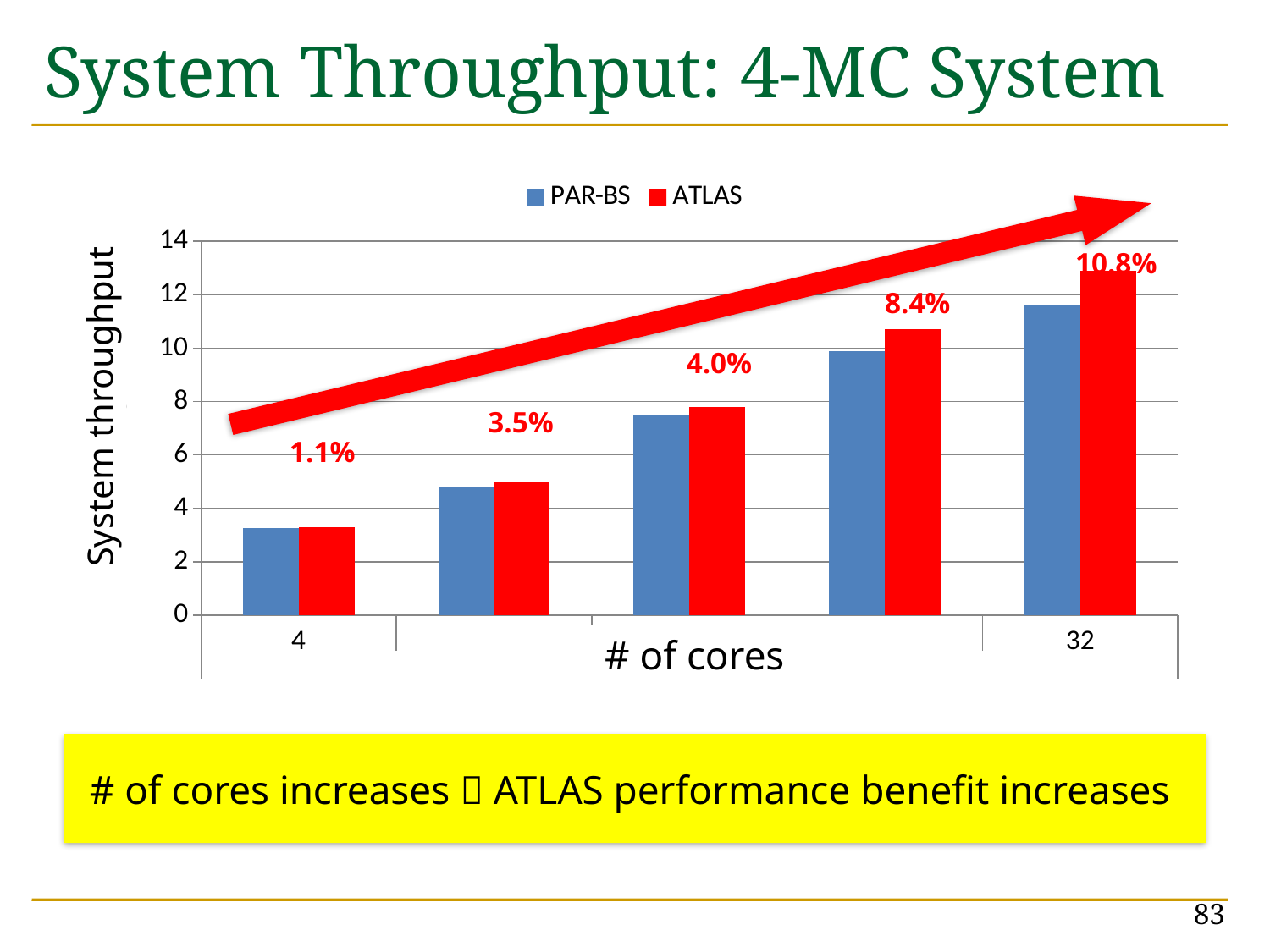
Is the ATLAS system throughput at 32 cores greater or less than 12? greater Which core count has the lowest system throughput? 4 Which colour represents the ATLAS series in the legend? red Which core count has the highest system throughput? 32 How many series does the legend list? 2 Is the PAR-BS system throughput at 32 cores greater or less than 10? greater What percentage is annotated above the bars for 32 cores? 10.8% How many groups of bars (core counts) are plotted on the x axis? 5 What kind of chart is shown on the slide? bar chart Is the PAR-BS system throughput at 4 cores greater or less than 4? less Do the system throughput values rise or fall as the number of cores increases along the x axis? rise At 32 cores, which series has the larger system throughput, PAR-BS or ATLAS? ATLAS